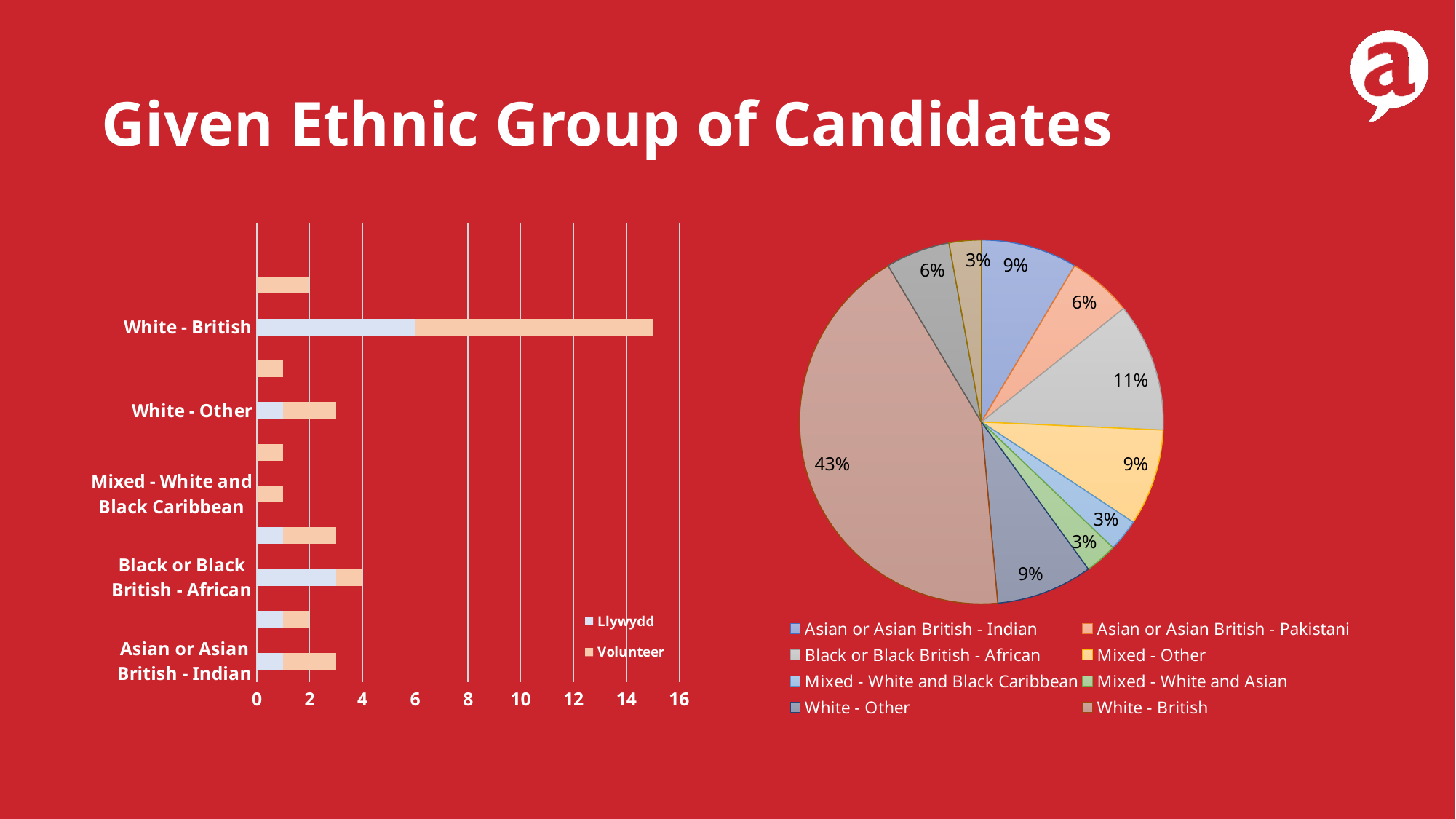
What kind of chart is the chart on the left of the slide? bar chart In the bar chart on the left, what are the two series named in the legend? Llywydd and Volunteer What kind of chart is the chart on the right of the slide? pie chart In the bar chart on the left, is the Volunteer segment for White - British greater or less than 8? greater In the pie chart on the right, which category has the largest slice? White - British In the pie chart on the right, what share does Asian or Asian British - Pakistani have? 6% In the pie chart on the right, what share does White - British have? 43% In the pie chart on the right, what is the difference in percentage points between the White - British slice and the Black or Black British - African slice? 32 In the pie chart on the right, what share does Asian or Asian British - Indian have? 9% In the pie chart on the right, which slice is larger: Black or Black British - African or Asian or Asian British - Pakistani? Black or Black British - African In the bar chart on the left, how many series does the legend list? 2